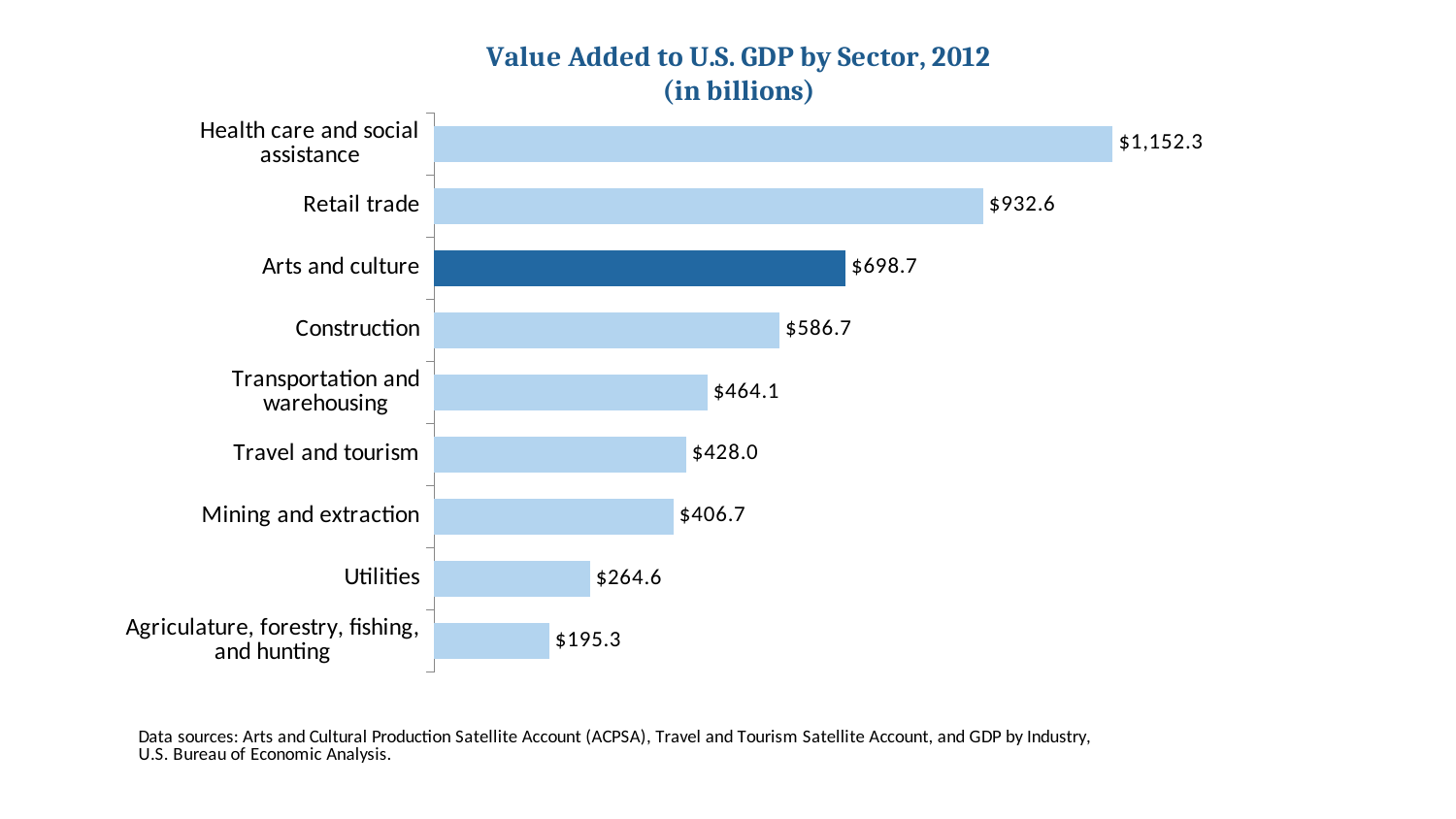
Which sector's bar is shown in a darker blue than the others? Arts and culture Which sector has a larger value added: Transportation and warehousing or Travel and tourism? Transportation and warehousing How many sectors are shown in the chart? 9 What is the value added to U.S. GDP by the Arts and culture sector? $698.7 What is the value shown for Utilities? $264.6 What is the value added to U.S. GDP by Retail trade? $932.6 Which sector has the lowest value added to U.S. GDP? Agriculature, forestry, fishing, and hunting What is the title of the chart? Value Added to U.S. GDP by Sector, 2012 (in billions) What is the difference between the values for Travel and tourism and Mining and extraction? $21.3 Which sector has the highest value added to U.S. GDP? Health care and social assistance What is the difference between the values for Arts and culture and Construction? $112.0 What kind of chart is shown on the slide? Bar chart